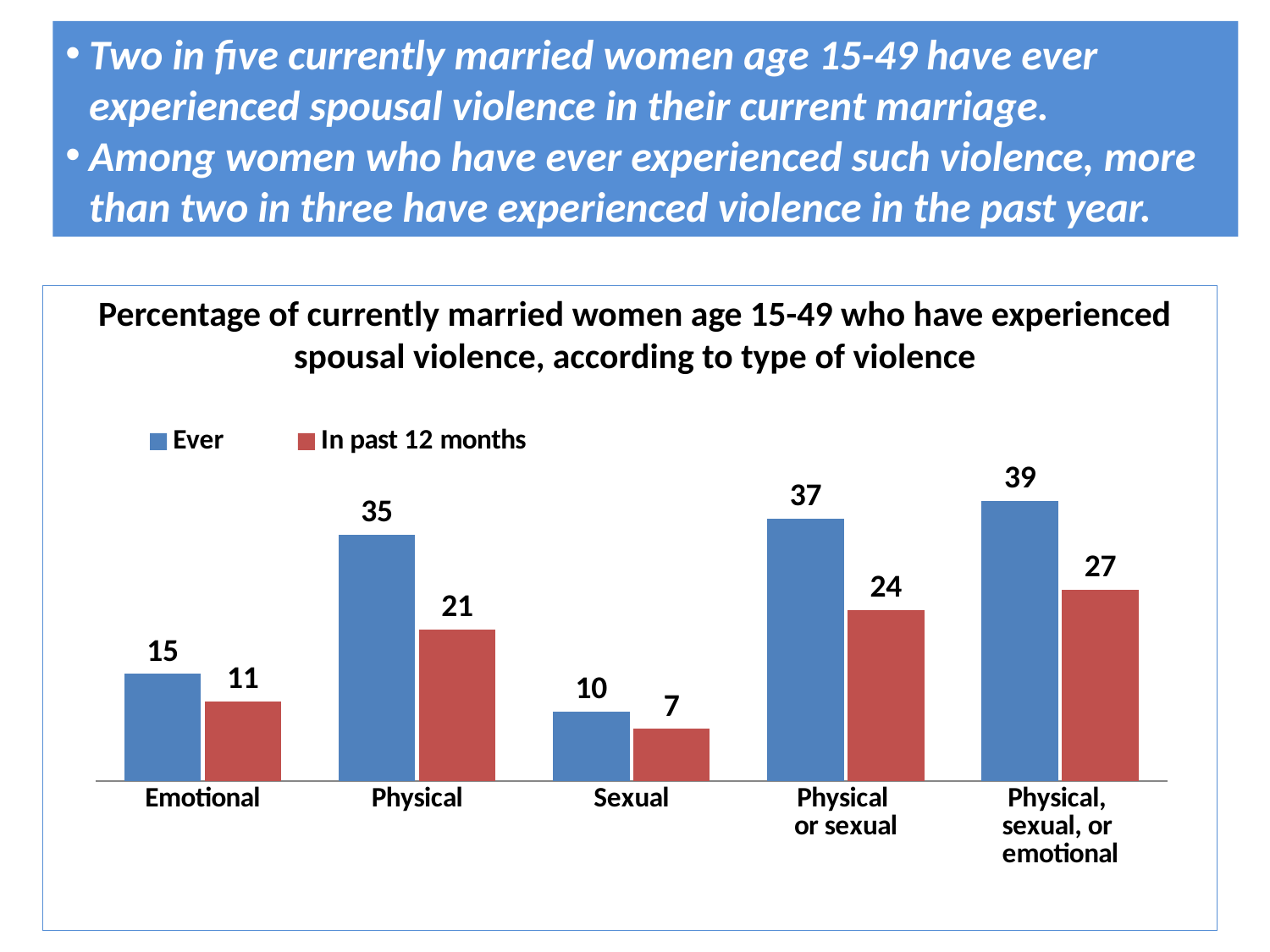
What is the 'In past 12 months' value for Sexual violence? 7 Which is larger: the 'Ever' value for Emotional violence or the 'In past 12 months' value for Physical violence? In past 12 months value for Physical What is the 'Ever' value for Physical violence? 35 What is the difference between the 'Ever' and 'In past 12 months' values for Physical or sexual violence? 13 What kind of chart is shown on the slide? Bar chart How many series does the legend list? 2 What are the two series named in the legend? Ever; In past 12 months What is the 'In past 12 months' value for 'Physical, sexual, or emotional' violence? 27 Which type of violence has the lowest 'In past 12 months' value? Sexual Which type of violence has the highest 'Ever' value? Physical, sexual, or emotional What is the 'Ever' value for Emotional violence? 15 How many types of violence are shown on the x axis? 5